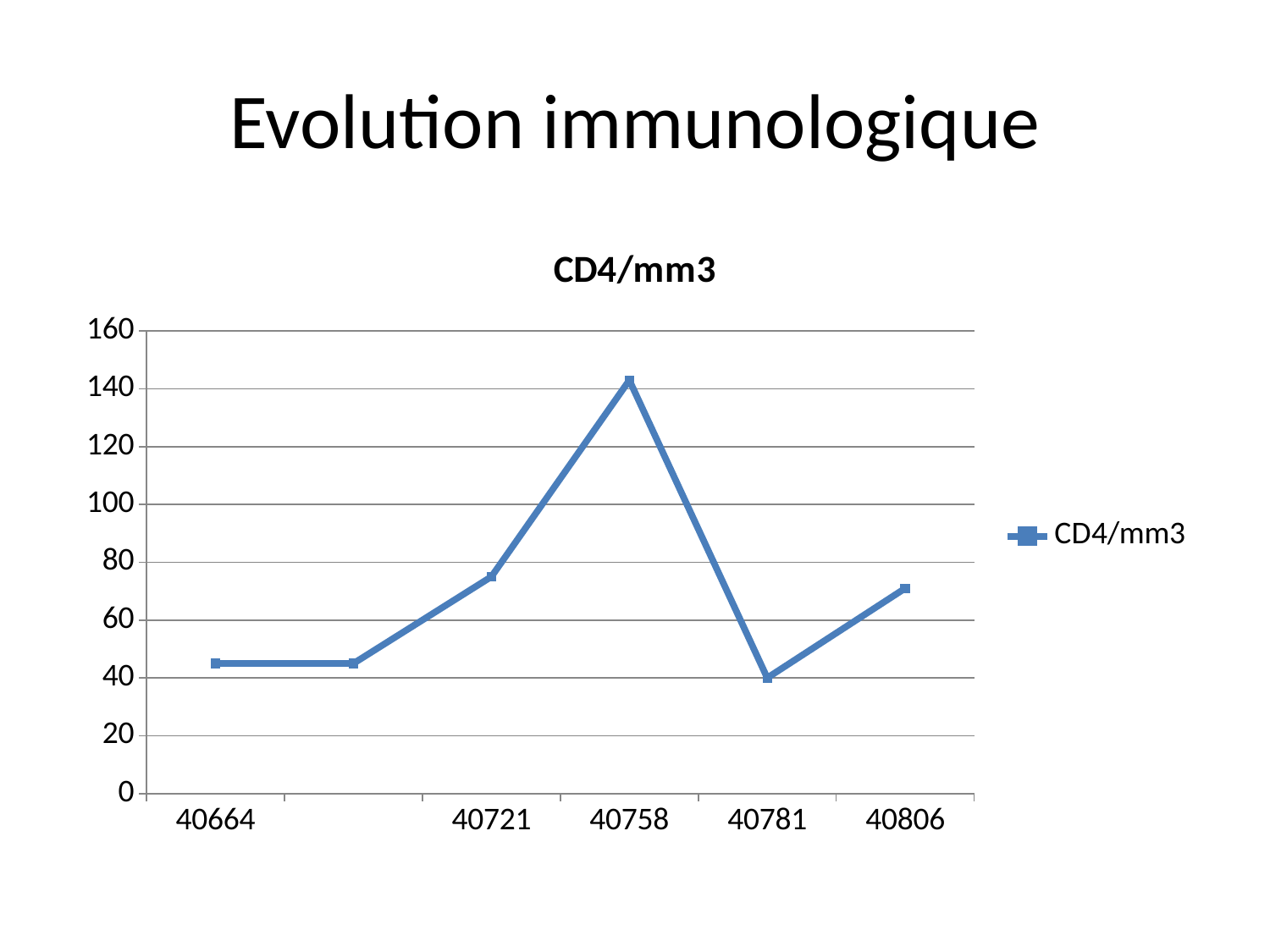
Is the CD4/mm3 value at 40806 greater or less than 60? greater Is the CD4/mm3 value at 40721 greater or less than 80? less At which x-axis label does the CD4/mm3 value reach its lowest point? 40781 How many series does the legend list? 1 What kind of chart is shown on the slide? line chart Is the CD4/mm3 value at 40664 greater or less than 60? less What is the title of the chart? CD4/mm3 At which x-axis label does the CD4/mm3 value reach its highest point? 40758 How many data points are plotted on the line? 6 Does the CD4/mm3 value rise or fall between 40758 and 40781? fall Which has the larger CD4/mm3 value, 40721 or 40758? 40758